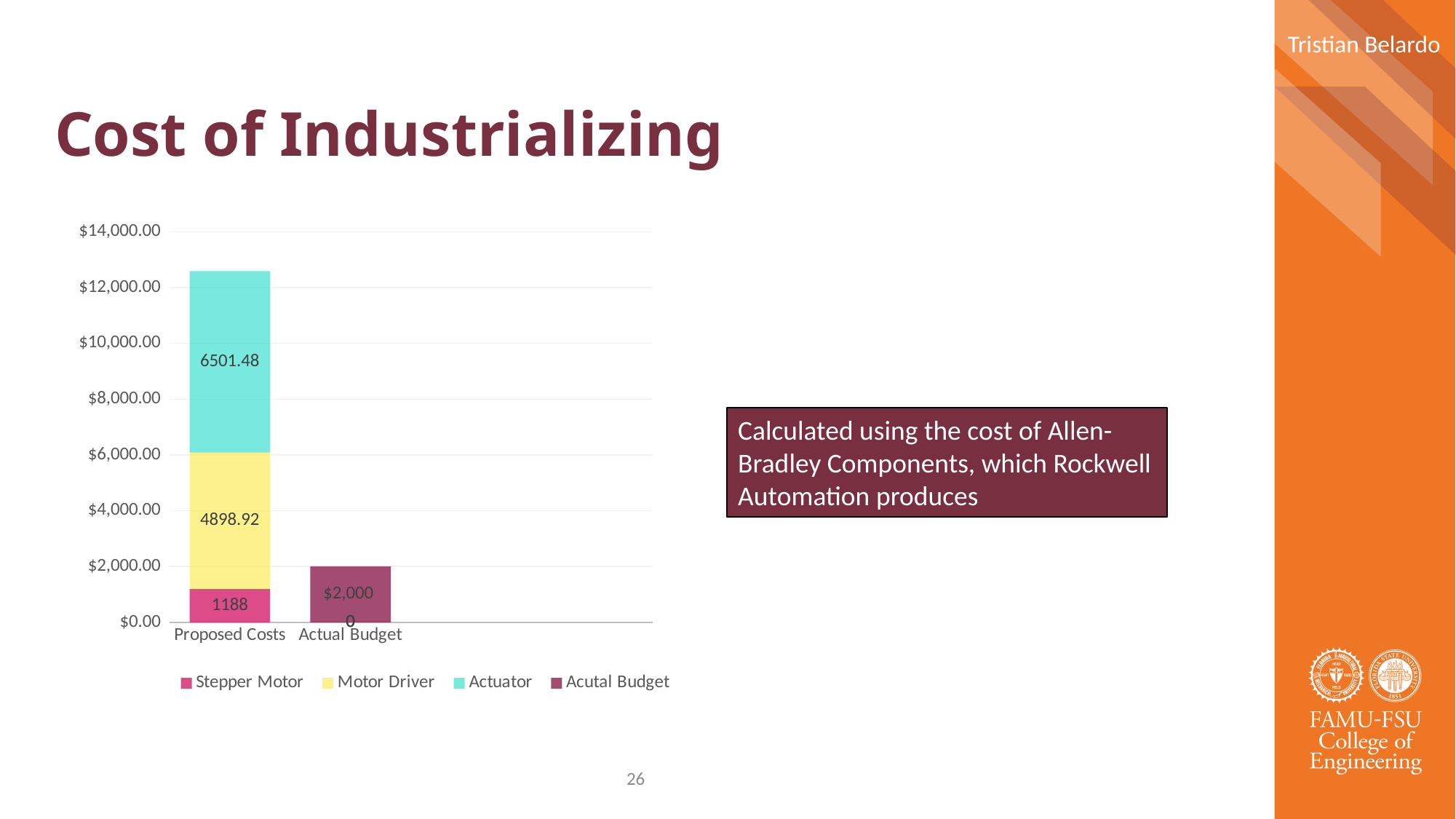
What is the value of the Stepper Motor segment in the Proposed Costs bar? 1188 Which segment of the Proposed Costs bar is the largest? Actuator Which segment of the Proposed Costs bar is the smallest? Stepper Motor How many series does the legend list? 4 Is the total of the Proposed Costs bar greater or less than $12,000.00? greater What is the value of the Motor Driver segment in the Proposed Costs bar? 4898.92 What value is labelled on the Actual Budget bar? $2,000 What is the total of the Proposed Costs stacked bar? 12588.40 What is the value of the Actuator segment in the Proposed Costs bar? 6501.48 Which is larger, the Motor Driver value or the Stepper Motor value? Motor Driver What kind of chart is shown on the slide? Stacked bar chart What is the difference between the Actuator and Motor Driver values in the Proposed Costs bar? 1602.56